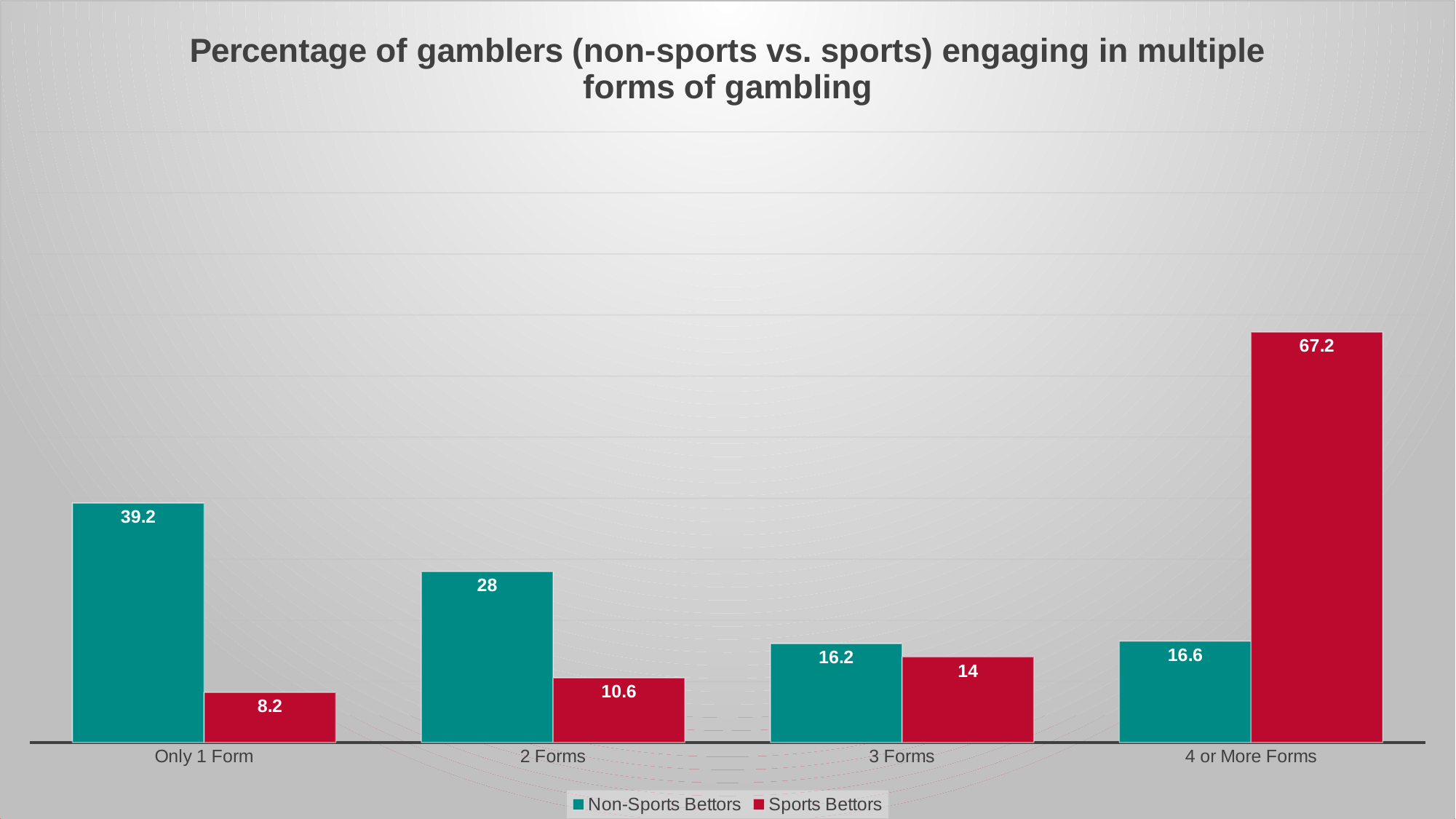
What is the value for Sports Bettors in the 4 or More Forms category? 67.2 What is the value for Sports Bettors in the 2 Forms category? 10.6 What colour represents Sports Bettors in the chart? Red Which category has the lowest value for Non-Sports Bettors? 3 Forms Which is larger in the 2 Forms category: Non-Sports Bettors or Sports Bettors? Non-Sports Bettors What is the difference between Non-Sports Bettors and Sports Bettors in the Only 1 Form category? 31 Which category has the highest value for Sports Bettors? 4 or More Forms How many categories are shown on the x axis? 4 What kind of chart is shown on the slide? Bar chart What is the value for Non-Sports Bettors in the Only 1 Form category? 39.2 How many series does the legend list? 2 What is the value for Non-Sports Bettors in the 3 Forms category? 16.2